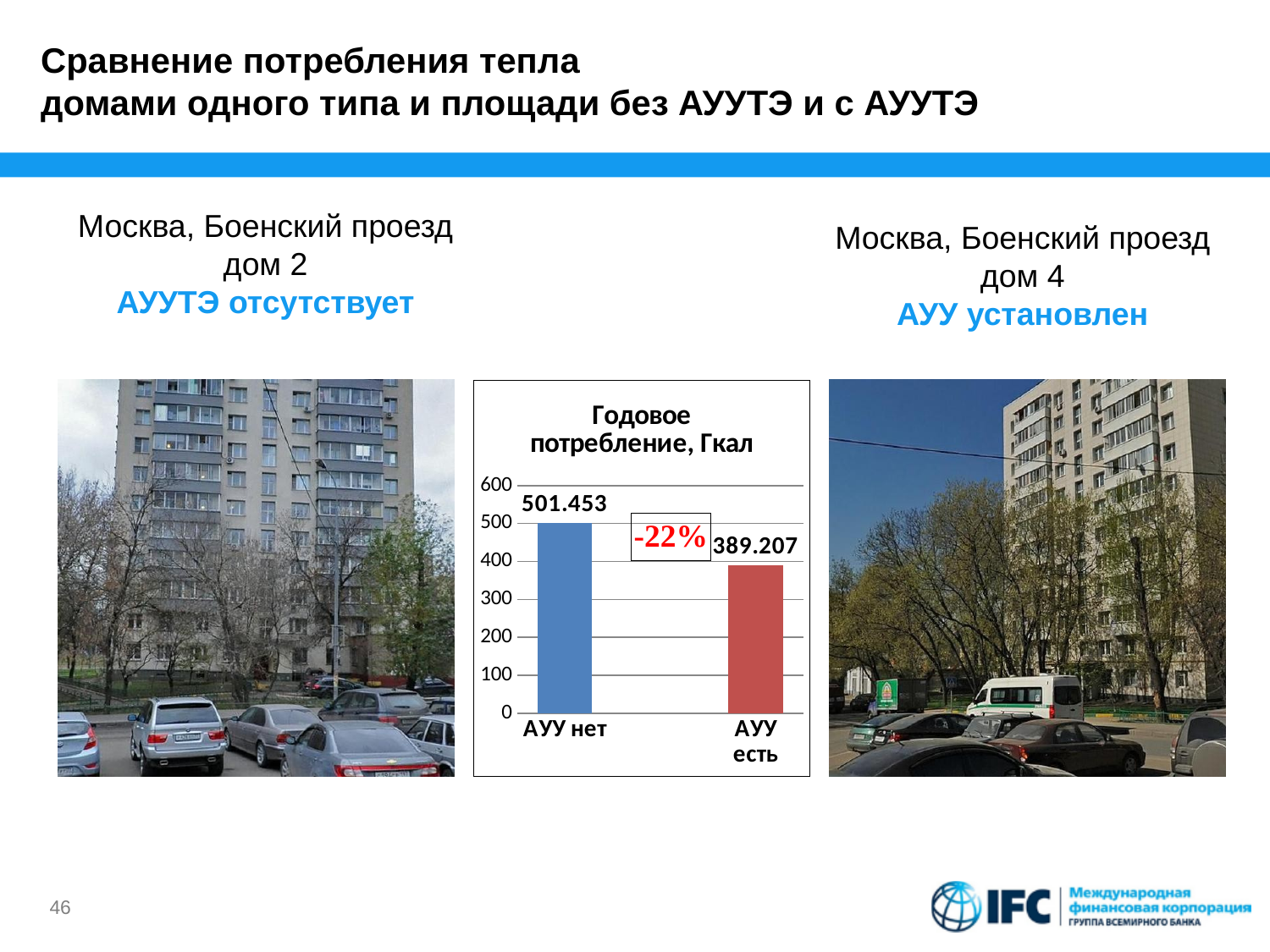
Is the value for "АУУ есть" greater or less than 400? less What is the annual consumption value for "АУУ есть"? 389.207 How many categories are shown in the chart? 2 Is the value for "АУУ есть" larger or smaller than the value for "АУУ нет"? smaller What is the annual consumption value for "АУУ нет"? 501.453 Which category has the higher annual consumption? АУУ нет Is the value for "АУУ нет" greater or less than 500? greater What type of chart is shown on the slide? bar chart Which category has the lower annual consumption? АУУ есть What percentage change is annotated between the two bars? -22% What is the difference between the values for "АУУ нет" and "АУУ есть"? 112.246 What is the title of the chart? Годовое потребление, Гкал